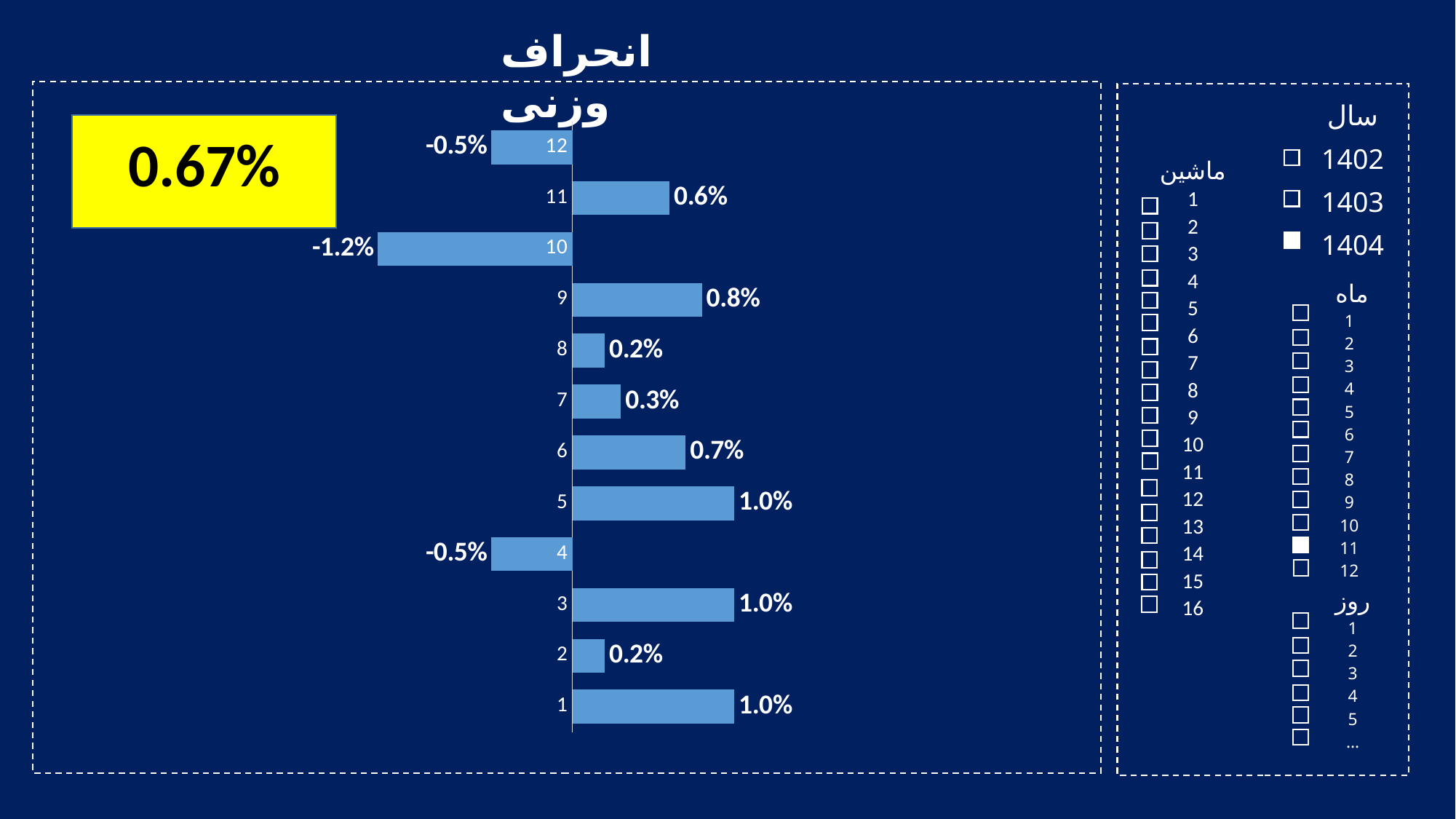
What is the value for category 9? 0.8% What type of chart is shown on the slide? bar chart What is the value for category 12? -0.5% What is the value for category 10? -1.2% What value is shown in the yellow box on the slide? 0.67% How many categories have a negative value? 3 Which is larger, the value for category 11 or the value for category 7? category 11 What is the difference between the values for category 9 and category 8? 0.6% What is the value for category 6? 0.7% Which category has the lowest value? 10 How many categories are plotted in the chart? 12 What is the title of the chart? انحراف وزنی